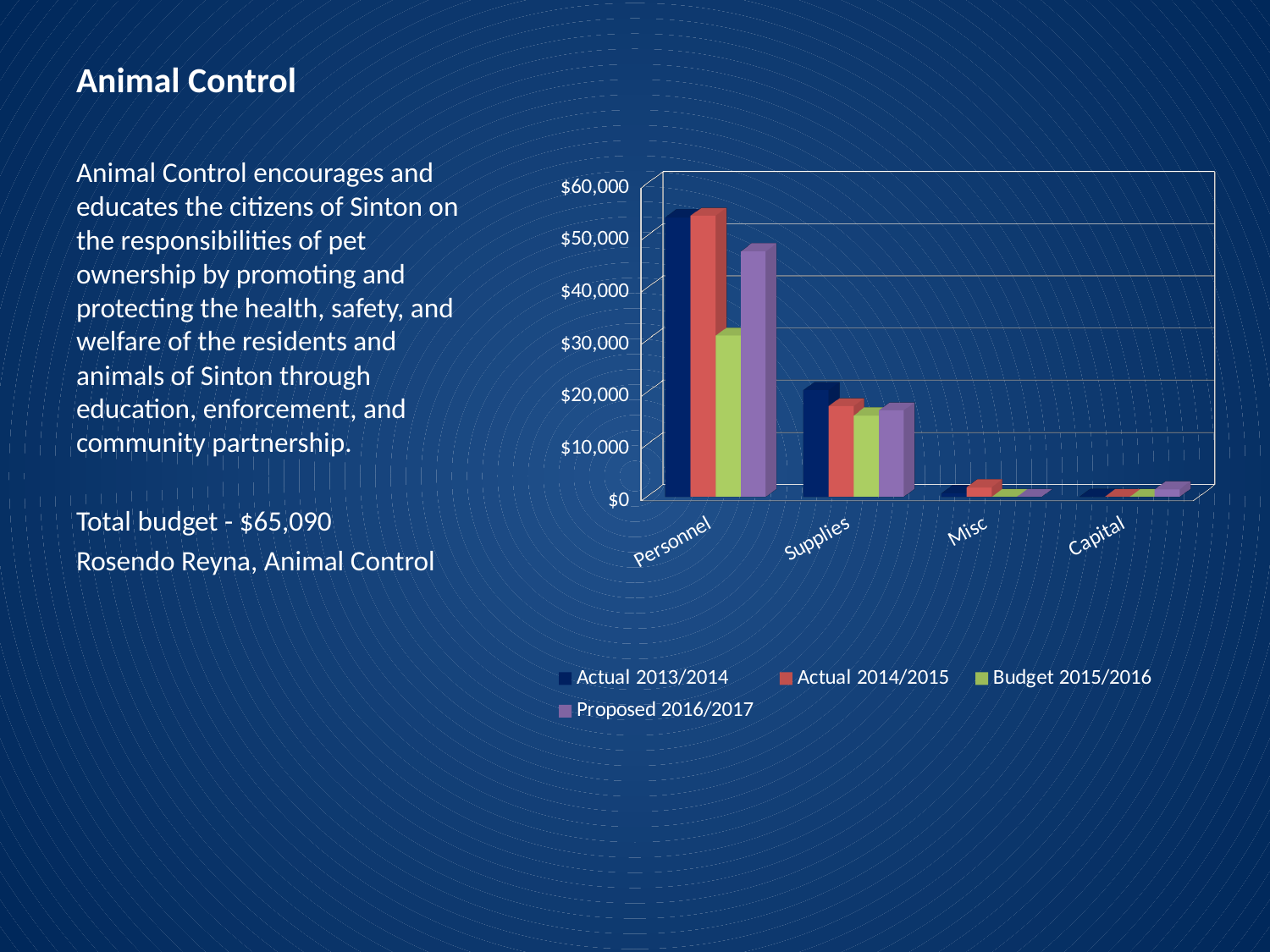
Which series is shown in red in the chart's legend? Actual 2014/2015 Is the Proposed 2016/2017 value for Personnel greater or less than $40,000? greater How many series does the chart's legend list? 4 For Personnel, which is larger: the Budget 2015/2016 value or the Proposed 2016/2017 value? Proposed 2016/2017 Is the Actual 2013/2014 value for Personnel greater or less than $50,000? greater Do the values generally rise or fall moving from Personnel to Capital along the x axis? fall What kind of chart is shown on the slide? bar chart Is the Budget 2015/2016 value for Supplies greater or less than $20,000? less Which category has the highest values in the chart? Personnel How many categories are shown on the x axis of the chart? 4